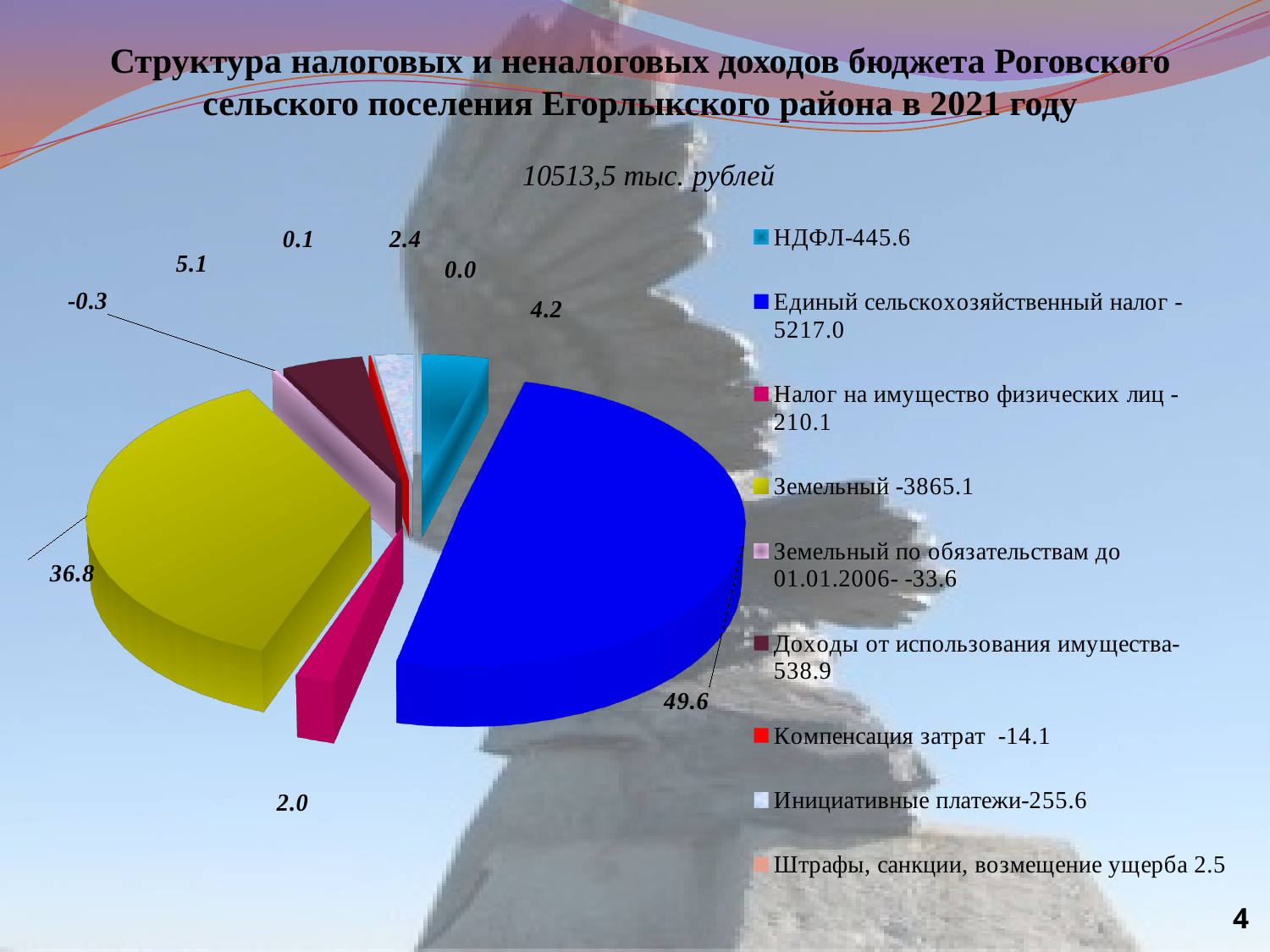
Which is larger: the legend value for Налог на имущество физических лиц or for Инициативные платежи? Инициативные платежи What is the value shown in the legend for НДФЛ? 445.6 What total amount is stated above the pie chart? 10513,5 тыс. рублей What is the value shown in the legend for Единый сельскохозяйственный налог? 5217.0 What is the value shown in the legend for Земельный? 3865.1 What kind of chart is shown on the slide? pie chart What is the value shown in the legend for Доходы от использования имущества? 538.9 What share of the pie does the yellow slice (Земельный) have, according to its data label? 36.8 What is the value shown in the legend for Инициативные платежи? 255.6 Which category has the largest slice of the pie? Единый сельскохозяйственный налог How many categories does the legend of the pie chart list? 9 What share of the pie does the largest slice (Единый сельскохозяйственный налог) have, according to its data label? 49.6